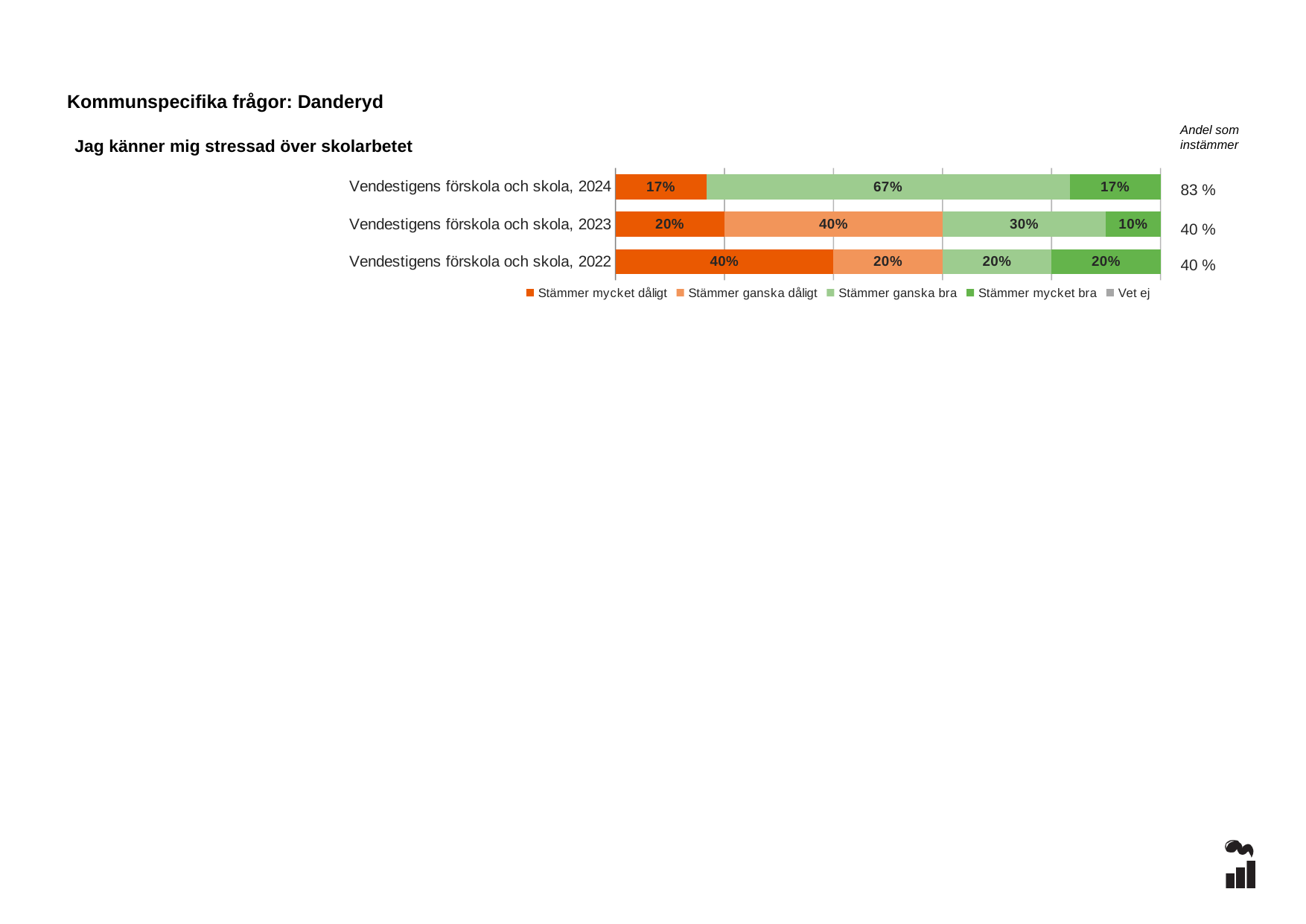
Which is larger: 'Stämmer ganska bra' for 2023 or 'Stämmer ganska bra' for 2022? 2023 What is the value for 'Stämmer ganska bra' for Vendestigens förskola och skola, 2024? 67% How many bars (categories) are shown in the chart? 3 Which year has the lowest value for 'Stämmer mycket bra'? Vendestigens förskola och skola, 2023 What kind of chart is shown on the slide? Stacked bar chart What is the 'Andel som instämmer' value shown for Vendestigens förskola och skola, 2024? 83 % Which year has the highest value for 'Stämmer ganska bra'? Vendestigens förskola och skola, 2024 What is the value for 'Stämmer ganska dåligt' for Vendestigens förskola och skola, 2023? 40% What is the value for 'Stämmer mycket bra' for Vendestigens förskola och skola, 2023? 10% What is the value for 'Stämmer mycket dåligt' for Vendestigens förskola och skola, 2022? 40% What is the difference between the 'Stämmer mycket dåligt' values for 2022 and 2024? 23 percentage points How many series does the legend list? 5